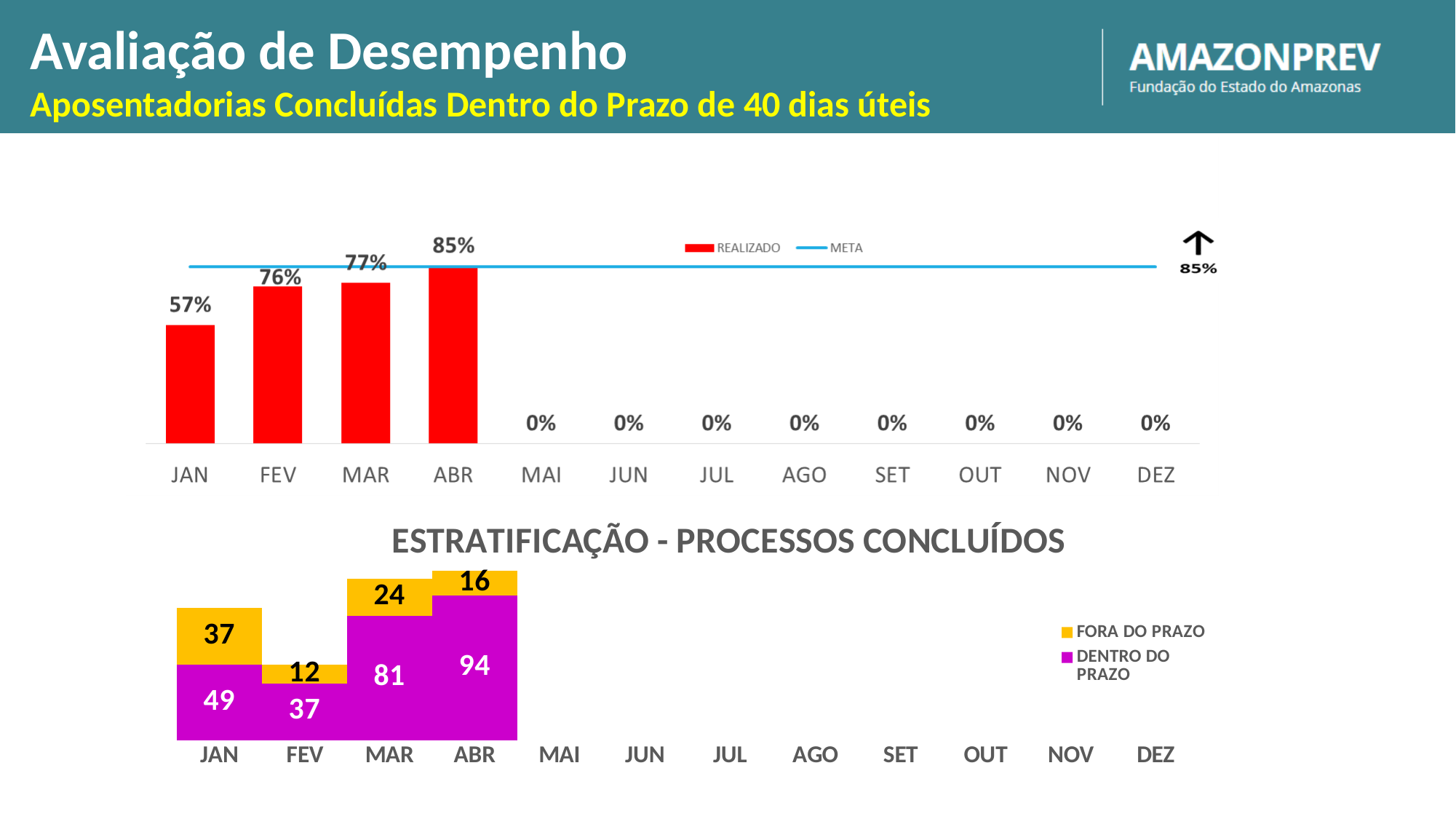
In the chart titled ESTRATIFICAÇÃO - PROCESSOS CONCLUÍDOS, what is the total of the stacked bar for ABR? 110 What kind of chart is the ESTRATIFICAÇÃO - PROCESSOS CONCLUÍDOS chart? stacked bar chart In the top chart, what is the REALIZADO value for JAN? 57% In the top chart, what is the difference between the REALIZADO values for ABR and JAN? 28% In the chart titled ESTRATIFICAÇÃO - PROCESSOS CONCLUÍDOS, what is the DENTRO DO PRAZO value for MAR? 81 In the chart titled ESTRATIFICAÇÃO - PROCESSOS CONCLUÍDOS, what is the FORA DO PRAZO value for FEV? 12 In the top chart, what is the META value shown? 85% In the top chart, do the REALIZADO values rise or fall from JAN to ABR? rise In the chart titled ESTRATIFICAÇÃO - PROCESSOS CONCLUÍDOS, which month has the highest FORA DO PRAZO value? JAN In the top chart, what is the REALIZADO value for MAR? 77% In the top chart, which month has the highest REALIZADO value? ABR In the top chart, how many series does the legend list? 2